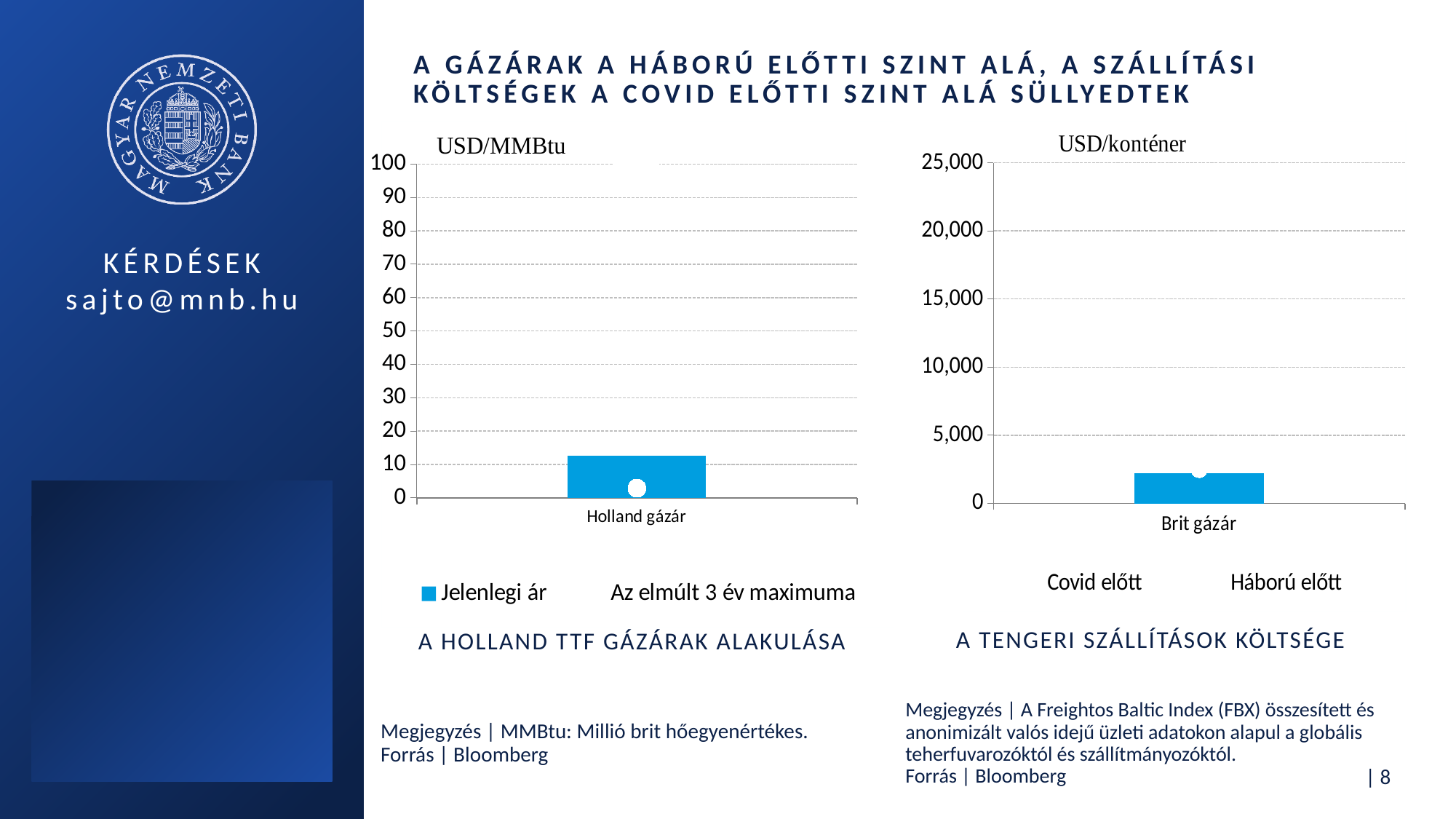
In the chart titled "A TENGERI SZÁLLÍTÁSOK KÖLTSÉGE", what kind of chart is shown? bar chart In the left chart (A HOLLAND TTF GÁZÁRAK ALAKULÁSA), is the bar for Holland gázár greater or less than 10? greater In the left chart (A HOLLAND TTF GÁZÁRAK ALAKULÁSA), is the bar for Holland gázár greater or less than 20? less In the right chart (A TENGERI SZÁLLÍTÁSOK KÖLTSÉGE), how many categories are shown on the x axis? 1 In the left chart (A HOLLAND TTF GÁZÁRAK ALAKULÁSA), how many categories are shown on the x axis? 1 In the right chart (A TENGERI SZÁLLÍTÁSOK KÖLTSÉGE), how many series does the legend list? 2 In the left chart (A HOLLAND TTF GÁZÁRAK ALAKULÁSA), what unit is shown on the vertical axis? USD/MMBtu In the right chart (A TENGERI SZÁLLÍTÁSOK KÖLTSÉGE), what unit is shown on the vertical axis? USD/konténer In the left chart (A HOLLAND TTF GÁZÁRAK ALAKULÁSA), how many series does the legend list? 2 In the chart titled "A HOLLAND TTF GÁZÁRAK ALAKULÁSA", what kind of chart is shown? bar chart In the right chart (A TENGERI SZÁLLÍTÁSOK KÖLTSÉGE), is the bar for Brit gázár greater or less than 5,000? less In the left chart (A HOLLAND TTF GÁZÁRAK ALAKULÁSA), what is the category label on the x axis? Holland gázár